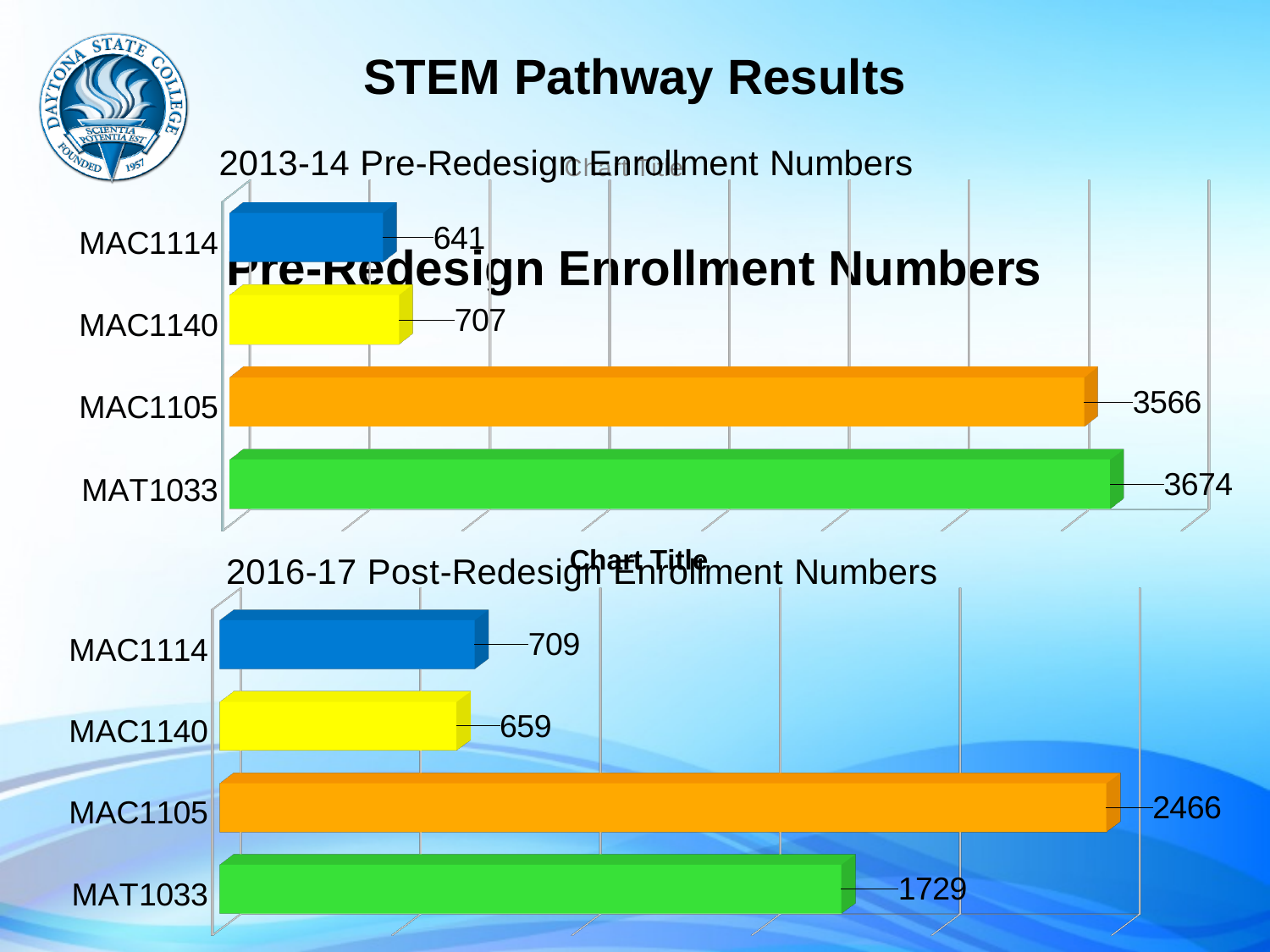
In the 2016-17 Post-Redesign Enrollment Numbers chart, which course has the lowest enrollment? MAC1140 In the 2013-14 Pre-Redesign Enrollment Numbers chart, what is the value for MAC1114? 641 In the 2016-17 Post-Redesign Enrollment Numbers chart, which course has the highest enrollment? MAC1105 In the 2013-14 Pre-Redesign Enrollment Numbers chart, which course has the highest enrollment? MAT1033 In the 2013-14 Pre-Redesign Enrollment Numbers chart, what is the difference between MAT1033 and MAC1105? 108 In the 2016-17 Post-Redesign Enrollment Numbers chart, what is the difference between MAC1105 and MAT1033? 737 In the 2016-17 Post-Redesign Enrollment Numbers chart, what is the value for MAC1140? 659 In the 2016-17 Post-Redesign Enrollment Numbers chart, which is larger, MAC1114 or MAC1140? MAC1114 In the 2016-17 Post-Redesign Enrollment Numbers chart, what is the value for MAT1033? 1729 How many courses are shown in the 2013-14 Pre-Redesign Enrollment Numbers chart? 4 In the 2013-14 Pre-Redesign Enrollment Numbers chart, what is the value for MAC1105? 3566 In the 2013-14 Pre-Redesign Enrollment Numbers chart, which course has the lowest enrollment? MAC1114